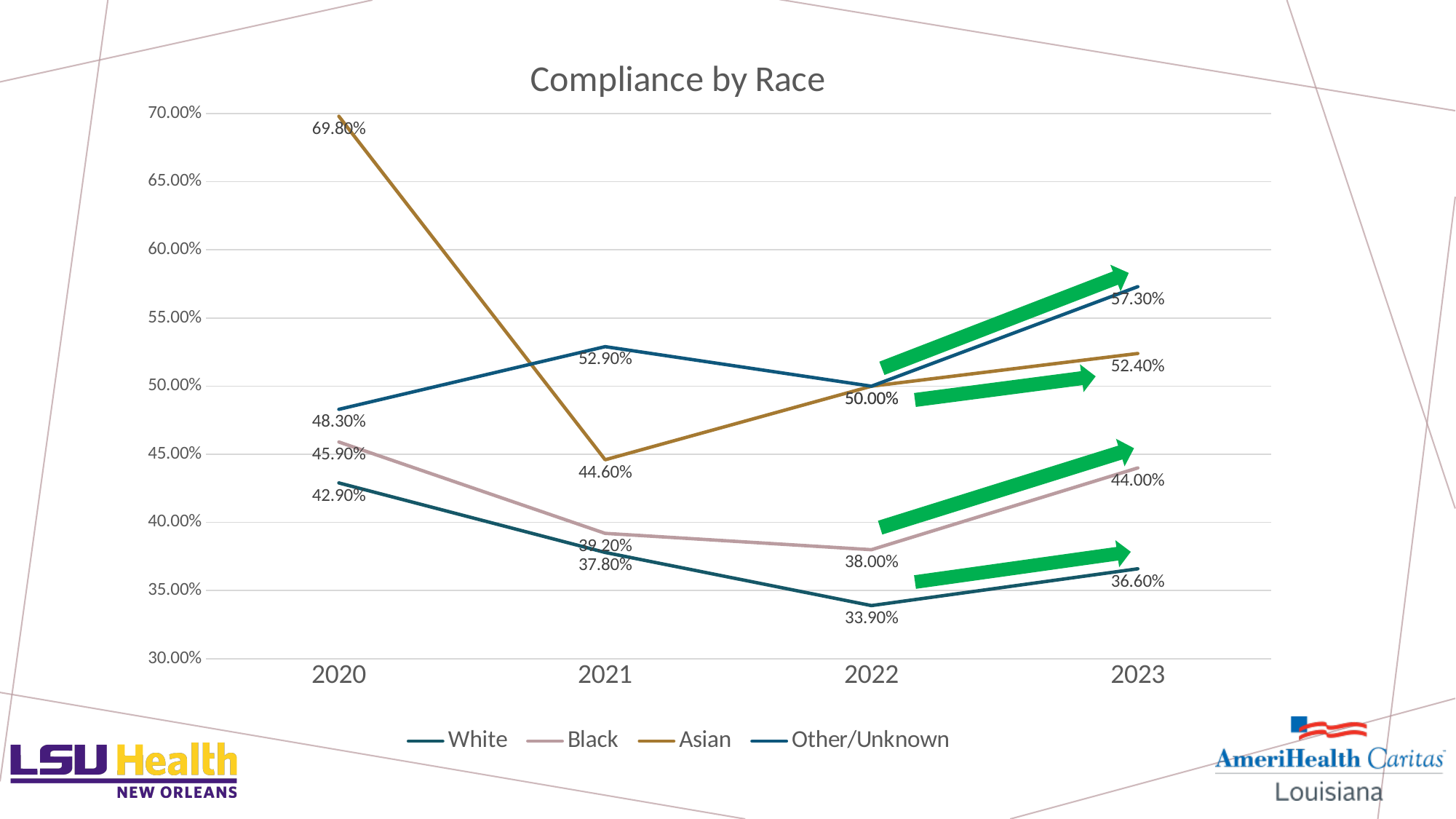
What is the compliance value for Asian in 2020? 69.80% How many series does the legend list? 4 Which race group had the highest compliance in 2020? Asian How many years are shown on the x axis? 4 By how many percentage points did the Asian compliance value drop from 2020 to 2021? 25.20 percentage points Which race group had the lowest compliance in 2023? White What is the compliance value for White in 2022? 33.90% What is the title of the chart? Compliance by Race What type of chart is shown on the slide? Line chart What is the compliance value for Black in 2023? 44.00% What is the compliance value for Other/Unknown in 2023? 57.30% Does the White series rise or fall from 2020 to 2022? Fall